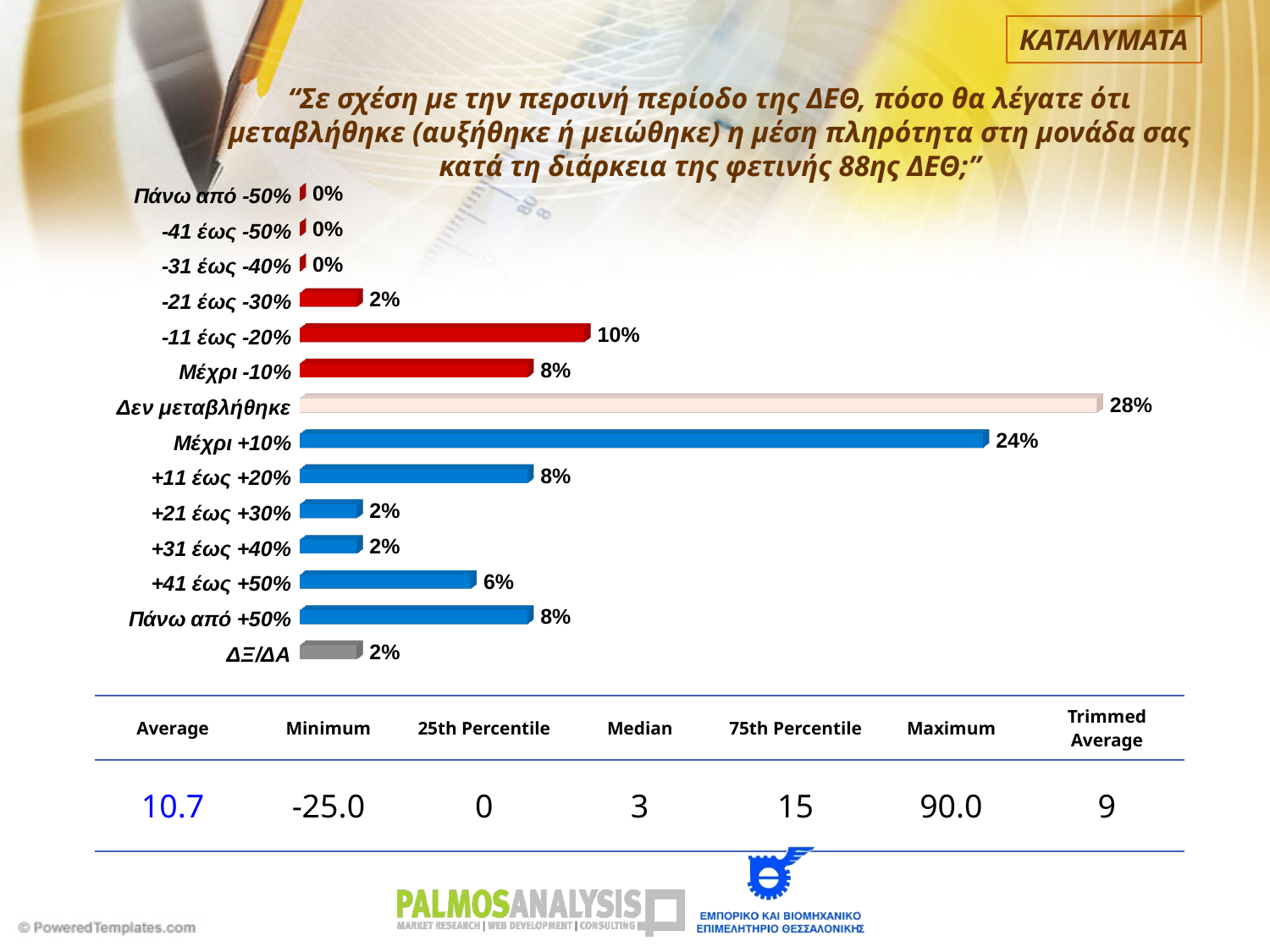
What is the value for "ΔΞ/ΔΑ"? 2% What is the value for "Μέχρι +10%"? 24% What kind of chart is shown on the slide? bar chart What is the difference between the values for "-11 έως -20%" and "Μέχρι -10%"? 2% Which is larger, the value for "Πάνω από +50%" or the value for "+41 έως +50%"? Πάνω από +50% Which category has the highest value? Δεν μεταβλήθηκε How many categories does the bar chart show? 14 What is the value for "Δεν μεταβλήθηκε"? 28% What is the difference between the values for "Δεν μεταβλήθηκε" and "Μέχρι +10%"? 4% What is the value for "-11 έως -20%"? 10% What is the combined value of "Μέχρι -10%" and "+11 έως +20%"? 16% What is the value for "+41 έως +50%"? 6%